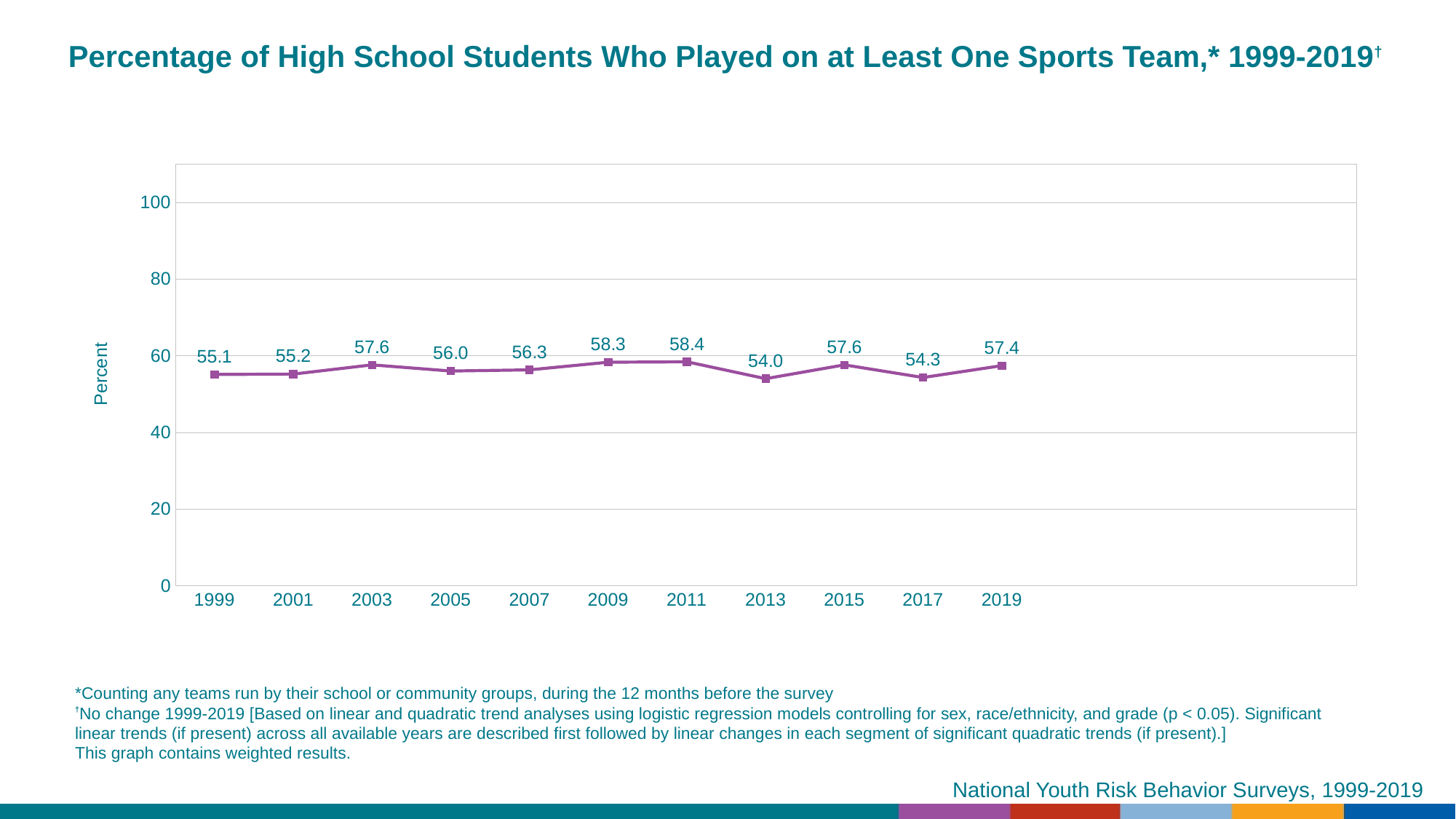
Is the value for 2005 greater or less than 60? less How many years are plotted on the chart? 11 What is the label on the y axis? Percent What is the value for 1999? 55.1 Which is larger, the value for 2009 or the value for 2017? 2009 What kind of chart is shown on the slide? line chart What is the difference between the values for 2019 and 1999? 2.3 Which year has the highest value? 2011 What is the value for 2019? 57.4 What is the value for 2013? 54.0 Which year has the lowest value? 2013 What is the difference between the values for 2011 and 2013? 4.4